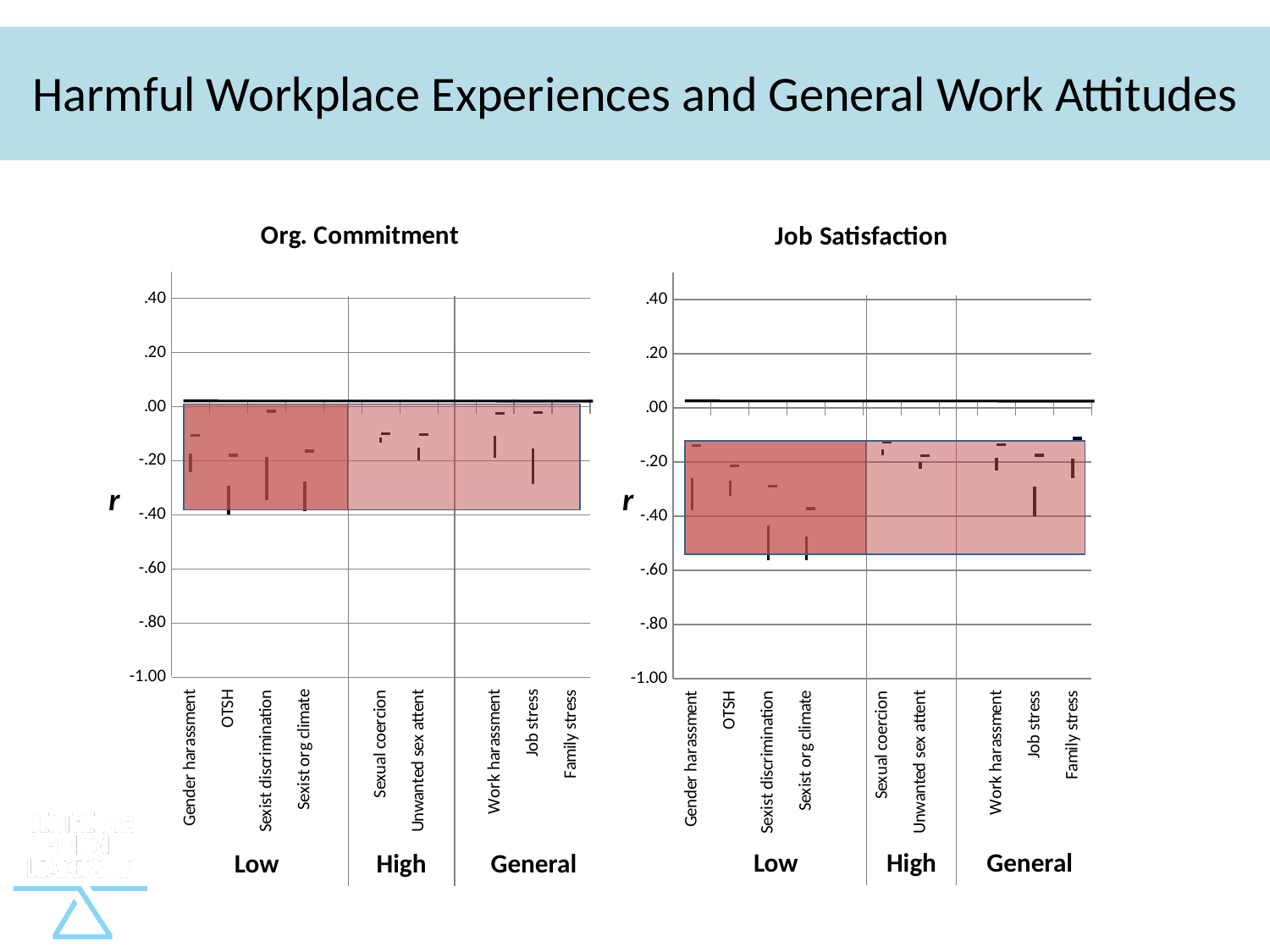
How many charts are shown on the slide? 2 What is the title of the chart on the right? Job Satisfaction In the Org. Commitment chart, how many categories are plotted along the x axis? 9 In the Job Satisfaction chart, how many categories are plotted along the x axis? 9 In the Job Satisfaction chart, is the value for Sexist org climate greater or less than -.20? less In the Job Satisfaction chart, is the value for Sexual coercion greater or less than -.40? greater What is the title of the chart on the left? Org. Commitment In the Org. Commitment chart, is the value for Sexual coercion greater or less than -.20? greater